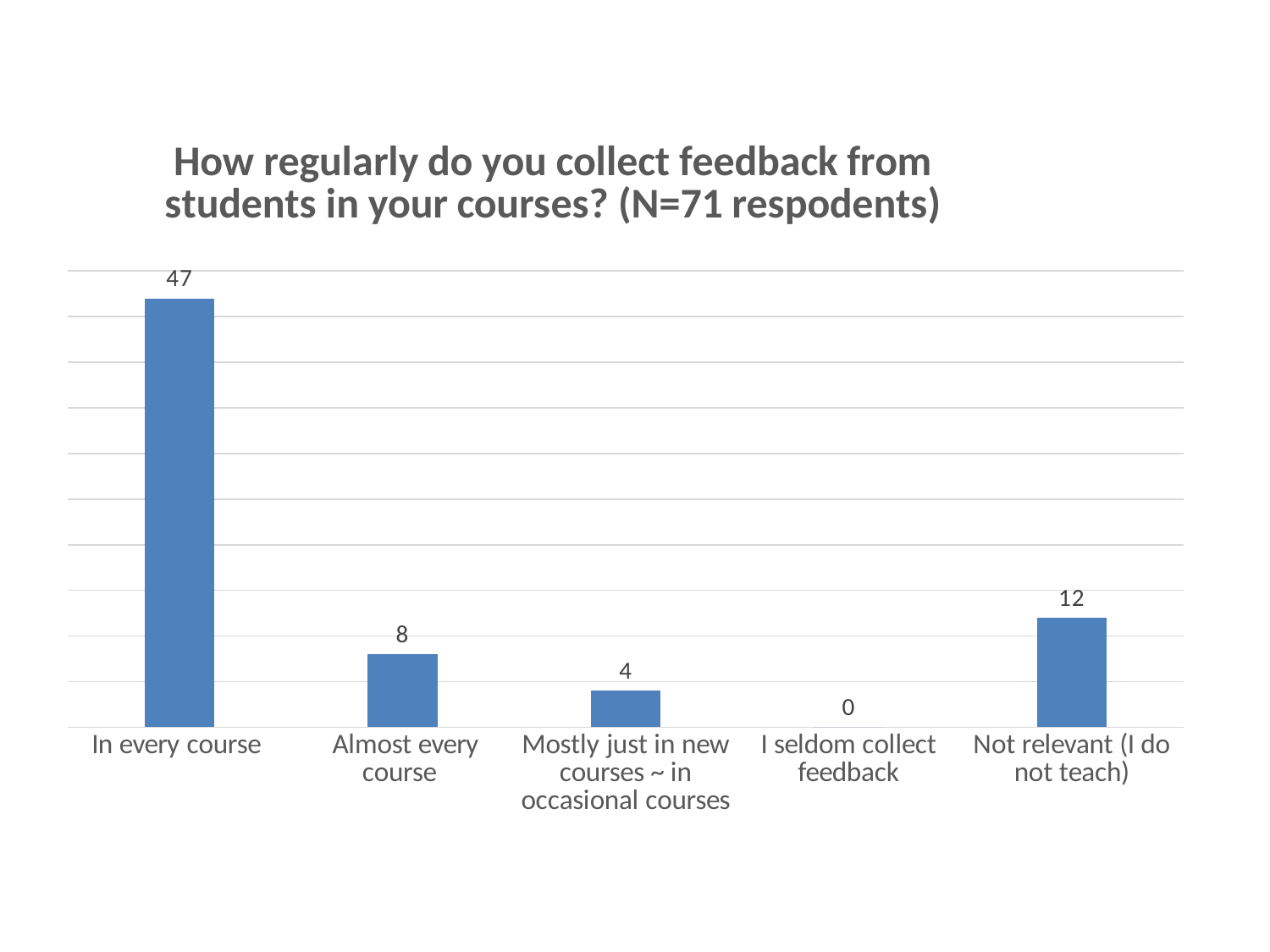
What is the value for "Mostly just in new courses ~ in occasional courses"? 4 Which category has the highest value? In every course Which category has the lowest value? I seldom collect feedback What is the value for "In every course"? 47 What is the value for "I seldom collect feedback"? 0 How many categories are shown on the x axis? 5 How many respondents does the chart title say took part? 71 What kind of chart is shown on the slide? Bar chart What is the value for "Not relevant (I do not teach)"? 12 What is the difference between the values for "In every course" and "Not relevant (I do not teach)"? 35 What is the value for "Almost every course"? 8 Which is larger, the value for "Almost every course" or the value for "Not relevant (I do not teach)"? Not relevant (I do not teach)